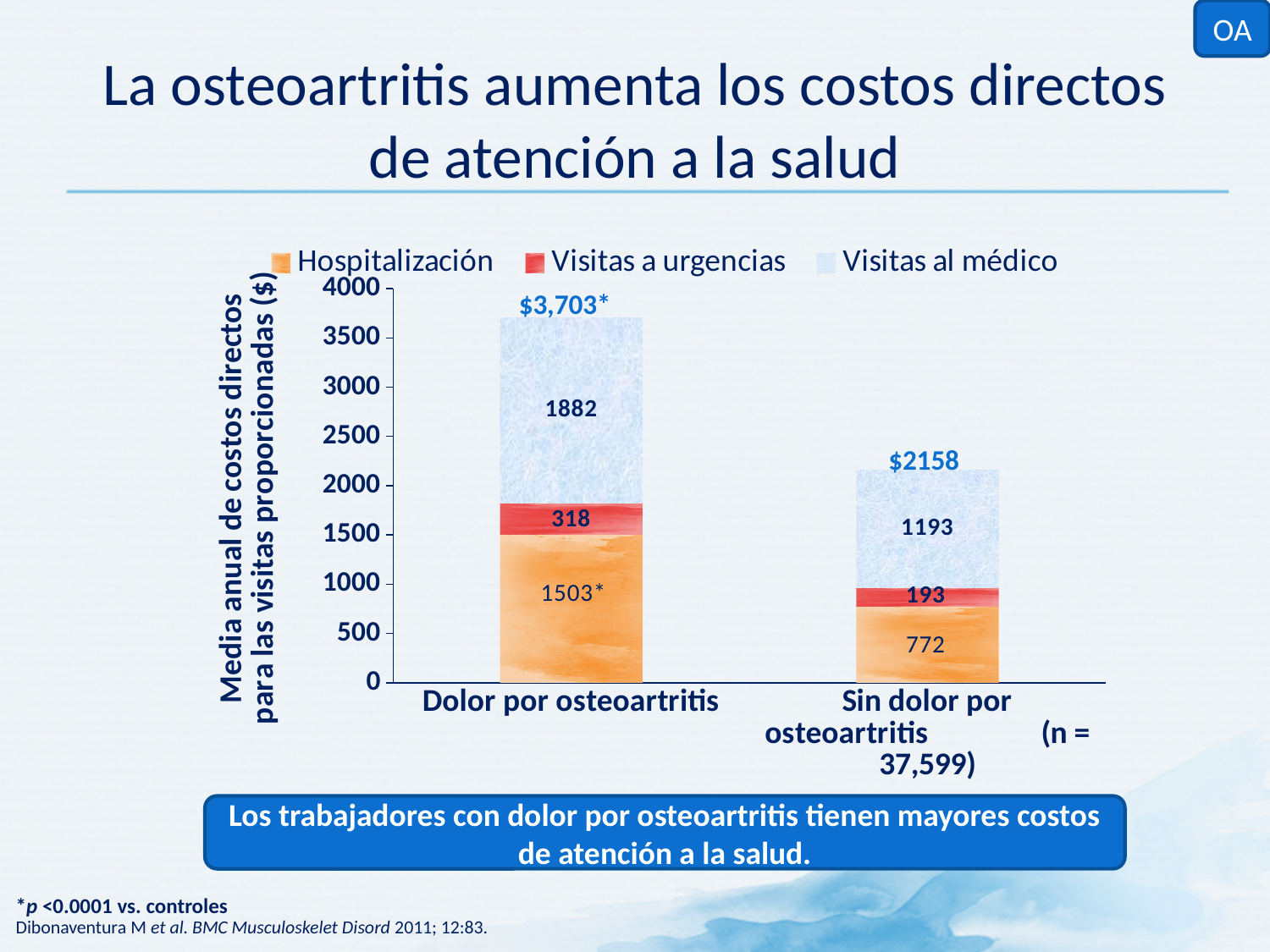
How many categories are shown on the x axis? 2 What is the Hospitalización value for Sin dolor por osteoartritis? 772 What is the Visitas a urgencias value for Dolor por osteoartritis? 318 What is the total labelled above the Sin dolor por osteoartritis bar? $2158 What is the Visitas al médico value for Dolor por osteoartritis? 1882 Which series is shown in red in the legend? Visitas a urgencias What is the difference between the Visitas al médico values for Dolor por osteoartritis and Sin dolor por osteoartritis? 689 What kind of chart is shown on the slide? Stacked bar chart What is the Visitas a urgencias value for Sin dolor por osteoartritis? 193 What is the total labelled above the Dolor por osteoartritis bar? $3,703* How many series does the legend list? 3 Which category has the higher Hospitalización value, Dolor por osteoartritis or Sin dolor por osteoartritis? Dolor por osteoartritis